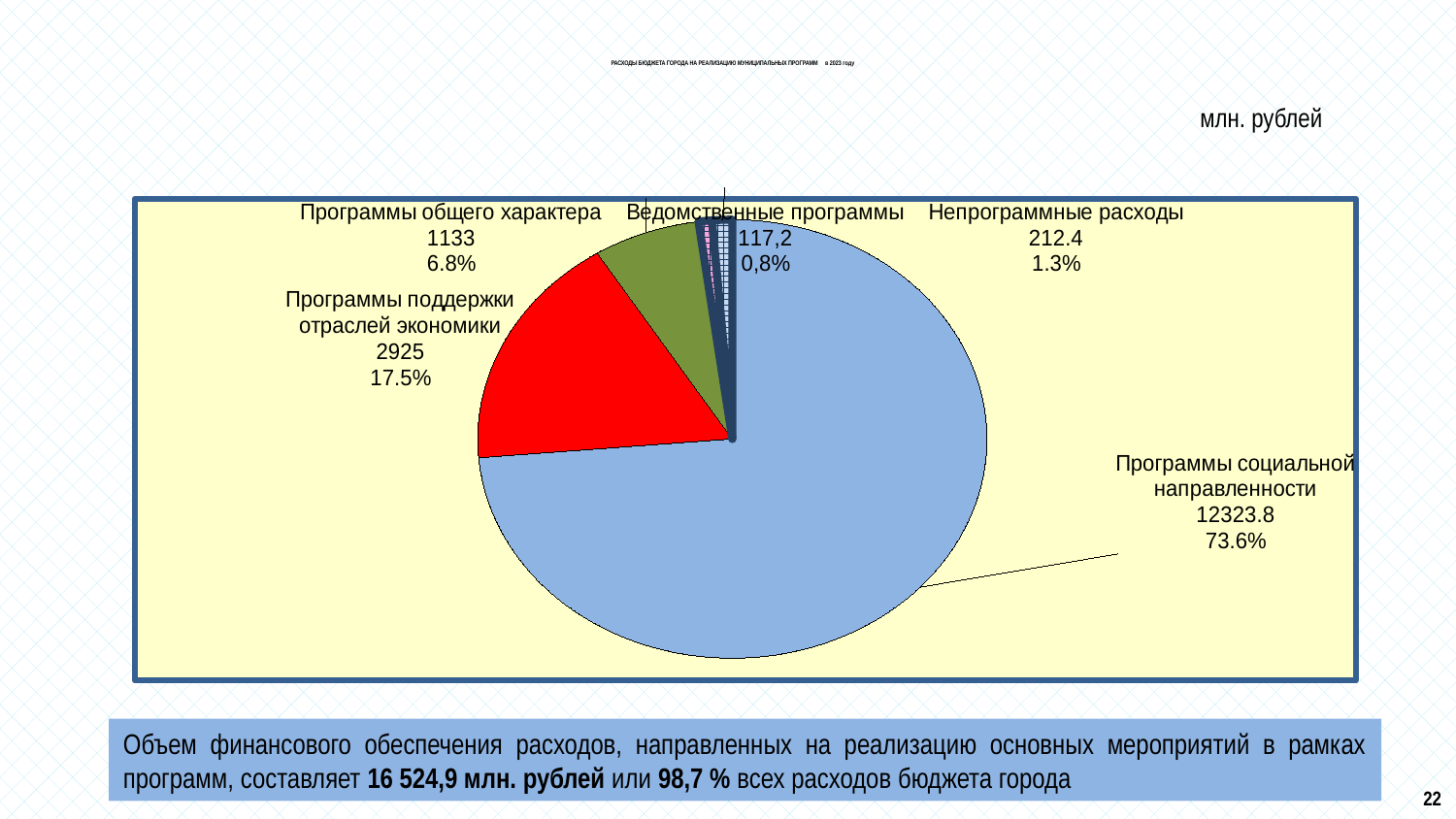
What is the value for Ведомственные программы? 117,2 Which category has the smallest slice of the pie? Ведомственные программы What share of the pie does Программы общего характера represent? 6.8% What kind of chart is shown on the slide? pie chart Which is larger: Программы общего характера or Непрограммные расходы? Программы общего характера How many slices does the pie chart have? 5 What share of the pie does Программы социальной направленности represent? 73.6% What is the value for Программы поддержки отраслей экономики? 2925 Which category has the largest slice of the pie? Программы социальной направленности What is the difference between the values for Программы поддержки отраслей экономики and Программы общего характера? 1792 What is the value for Непрограммные расходы? 212.4 What is the value for Программы социальной направленности? 12323.8